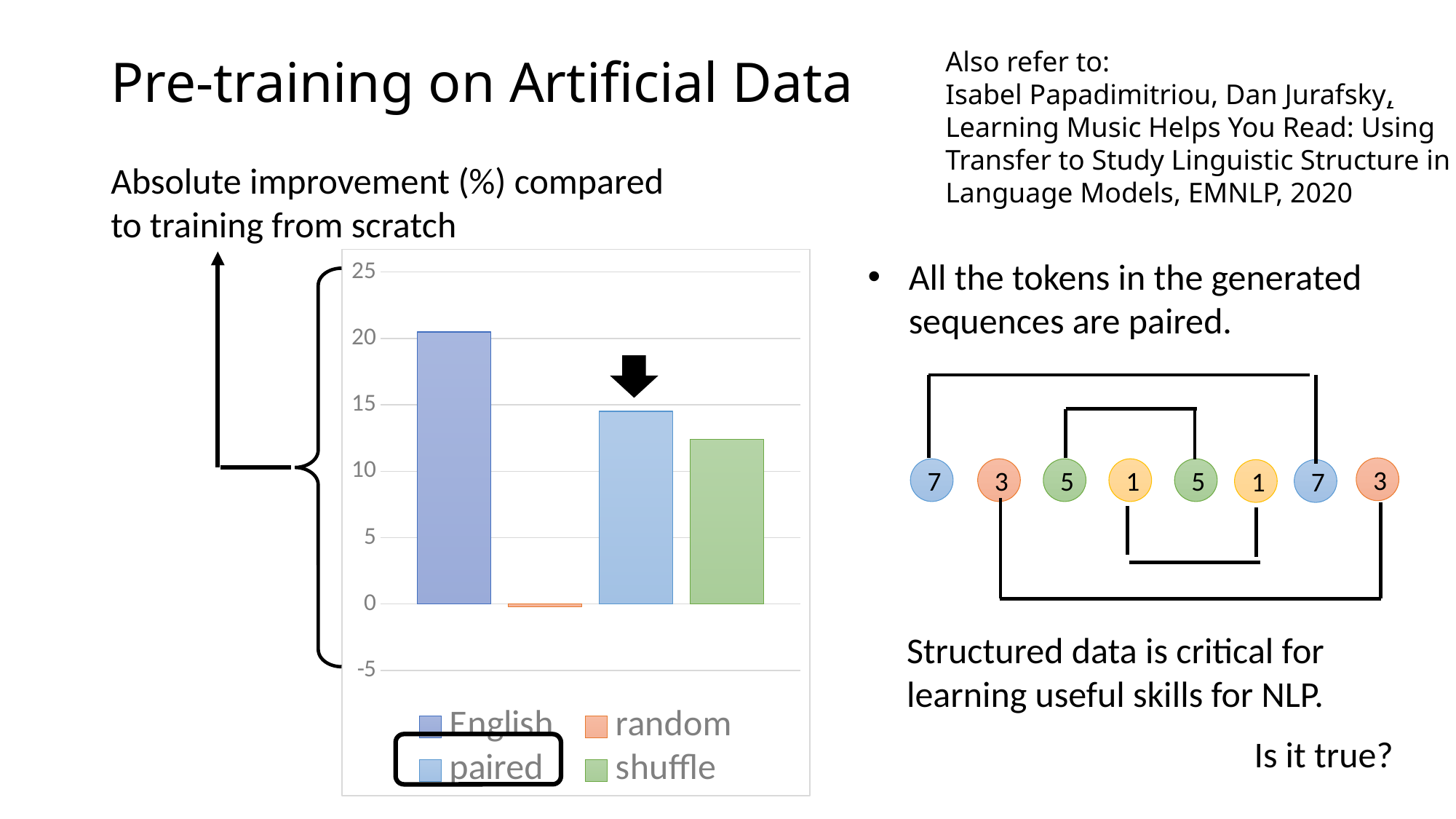
Which legend entry is outlined with a black box? paired Is the value for shuffle greater or less than 15? less Which is larger, the value for English or the value for paired? English Is the value for paired greater or less than 10? greater Is the value for English greater or less than 15? greater What kind of chart is shown on the slide? bar chart Which series has the lowest value in the chart? random How many series does the chart legend list? 4 How many bars are plotted in the chart? 4 Which series has the highest value in the chart? English Which is larger, the value for paired or the value for shuffle? paired